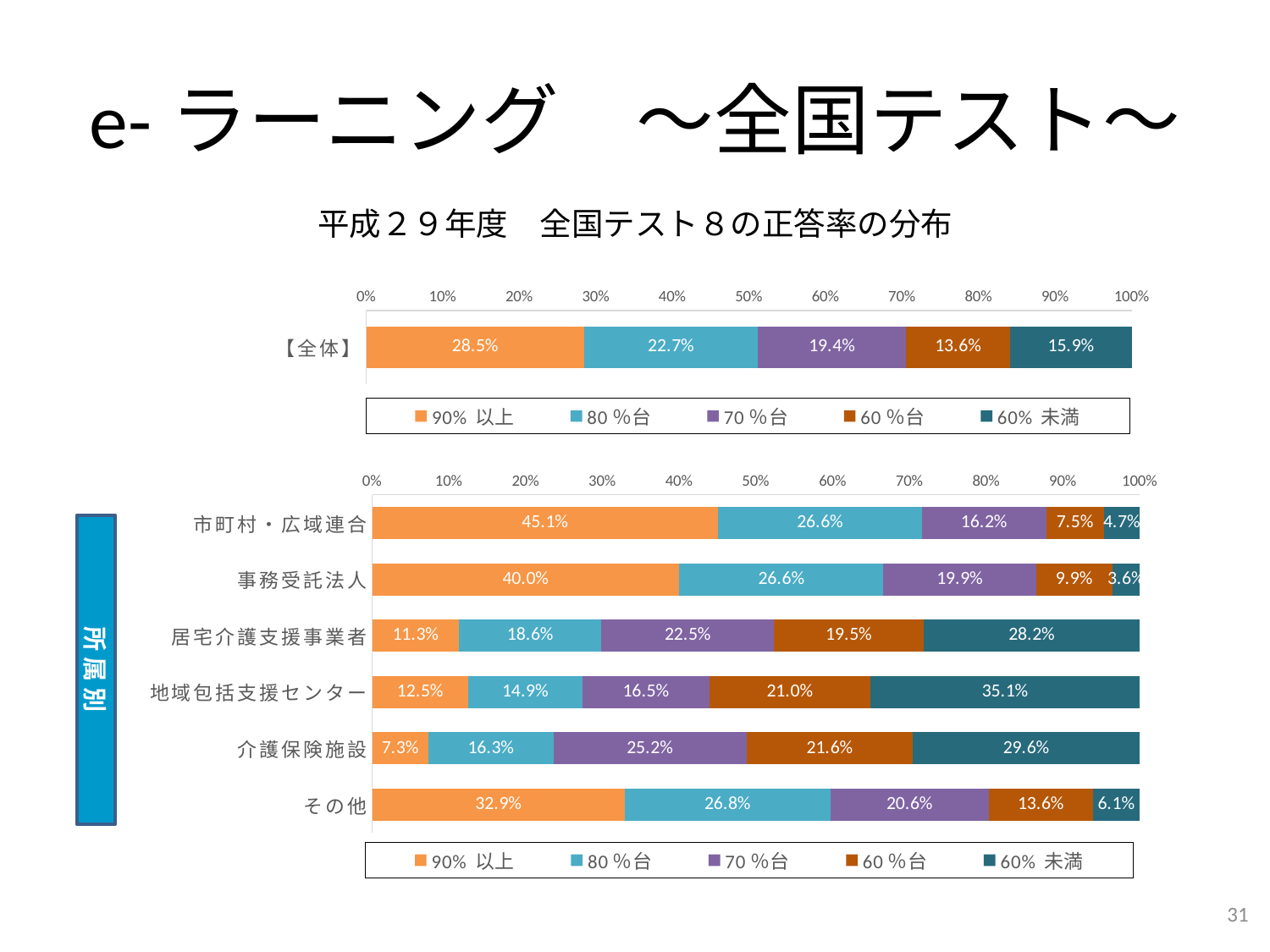
In the top chart (【全体】), what is the value for the 60% 未満 segment? 15.9% In the bottom chart (所属別), what is the 60% 未満 value for 地域包括支援センター? 35.1% In the bottom chart (所属別), which has the larger 60% 未満 value: 居宅介護支援事業者 or 介護保険施設? 介護保険施設 In the bottom chart (所属別), which category has the lowest 90% 以上 value? 介護保険施設 In the bottom chart (所属別), what is the 70%台 value for その他? 20.6% In the top chart (【全体】), what is the difference between the 90% 以上 segment and the 80%台 segment? 5.8% What kind of chart is the bottom chart (所属別)? Stacked bar chart In the top chart (【全体】), what is the value for the 90% 以上 segment? 28.5% How many series does the legend of the bottom chart list? 5 In the bottom chart (所属別), which category has the highest 90% 以上 value? 市町村・広域連合 In the bottom chart (所属別), what is the difference between the 90% 以上 values of 市町村・広域連合 and 事務受託法人? 5.1% How many categories are shown in the bottom chart (所属別)? 6